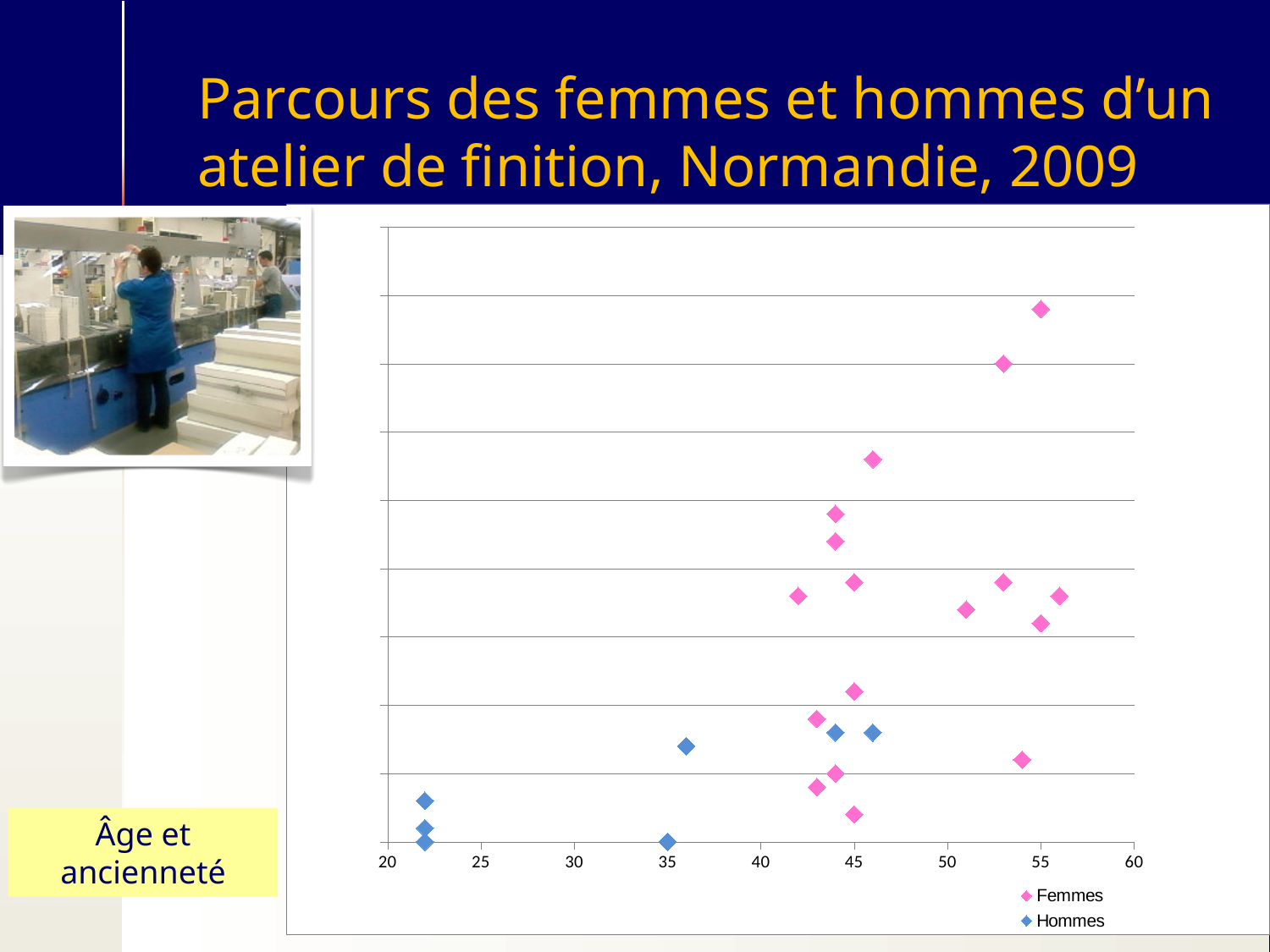
Which colour marks the Hommes series in the chart? Blue What is the lowest value shown on the x axis of the chart? 20 Which series contains the points with the smallest x values in the chart? Hommes Which series contains the point with the highest vertical position in the chart? Femmes How many Hommes points are plotted in the chart? 7 What kind of chart is shown on the slide? Scatter chart What are the two series named in the chart legend? Femmes and Hommes What is the highest value shown on the x axis of the chart? 60 How many series does the chart legend list? 2 Is the x value of the leftmost Hommes points greater or less than 25? less Is the x value of the highest Femmes point greater or less than 50? greater Are all Hommes points located at x values less than 50? Yes